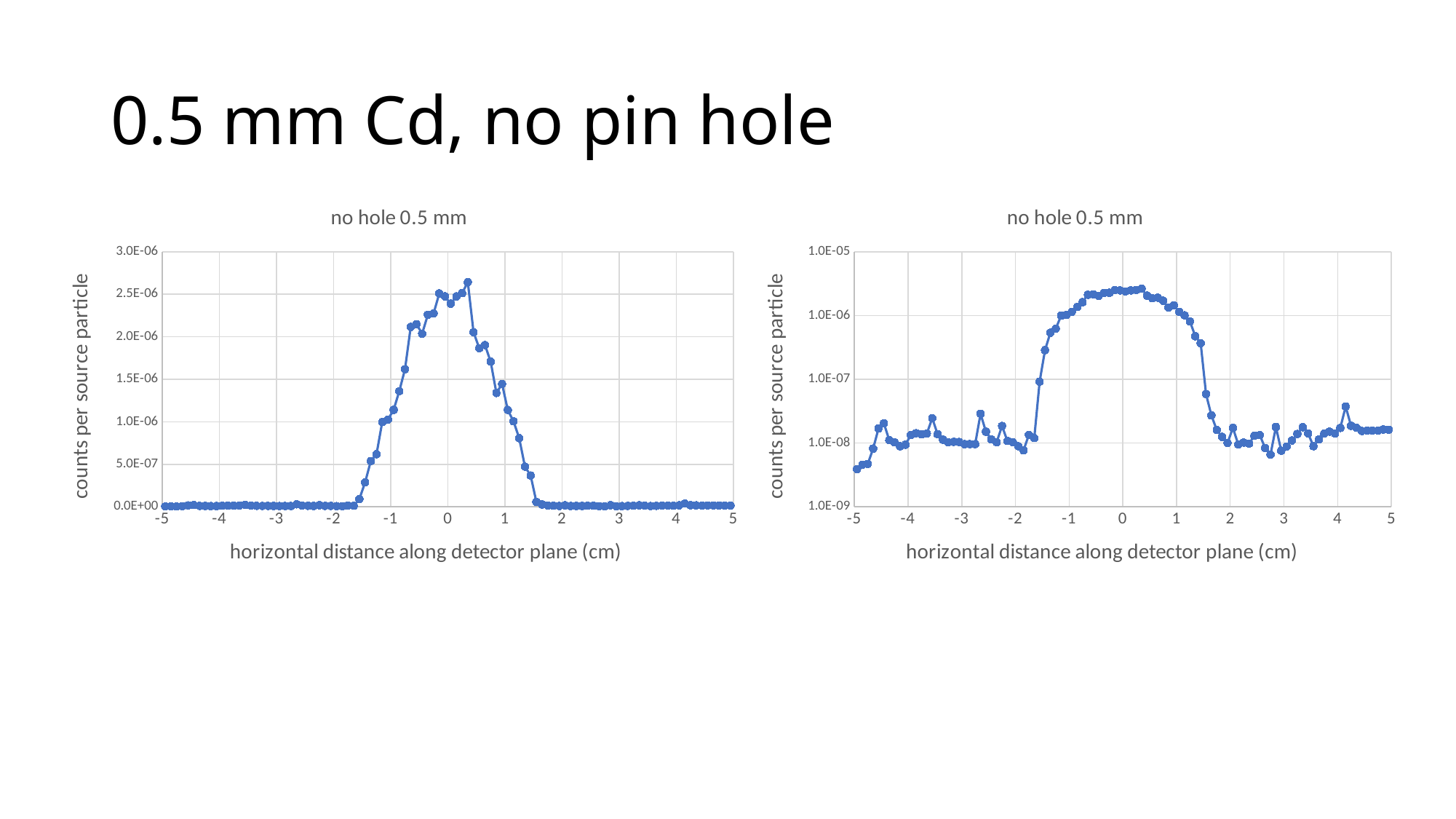
In the right chart, is the value at a horizontal distance of 0 cm greater or less than 1.0E-06? greater In the left chart, is the value at a horizontal distance of -2 cm greater or less than 5.0E-07? less In the right chart, is the value at a horizontal distance of 3 cm greater or less than 1.0E-07? less What is the y-axis label of the left chart? counts per source particle What kind of chart is the left chart on the slide? line chart In the left chart, do the values rise or fall as the horizontal distance goes from 0.5 cm to 1.5 cm? fall In the left chart, which has the larger value: the point at 0 cm or the point at 3 cm? 0 cm In the left chart, do the values rise or fall as the horizontal distance goes from -1.5 cm to 0 cm? rise What is the title of the right chart? no hole 0.5 mm